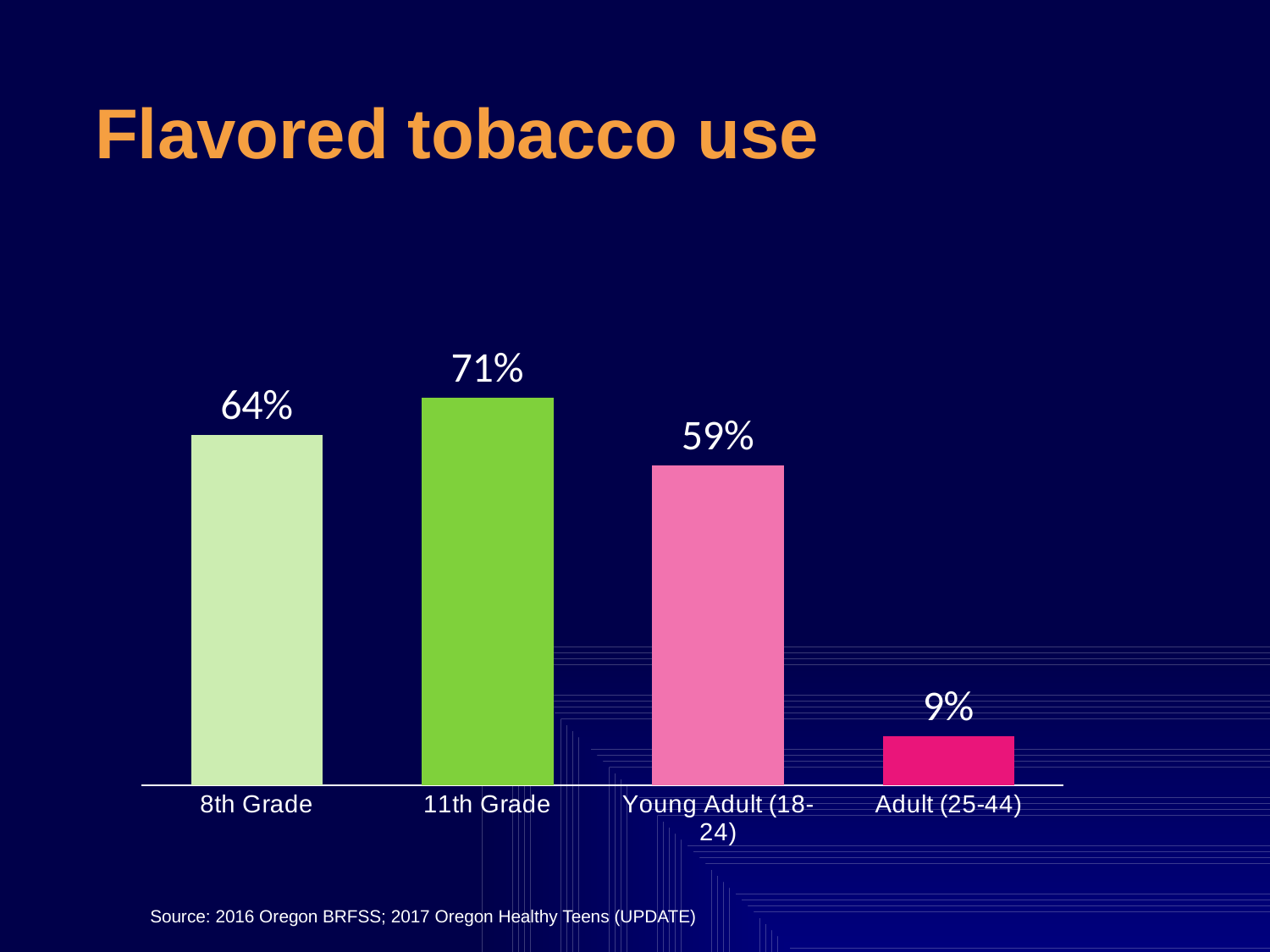
What is the difference between the Young Adult (18-24) and Adult (25-44) values? 50% Which category has the lowest flavored tobacco use? Adult (25-44) What is the flavored tobacco use value for 11th Grade? 71% What is the flavored tobacco use value for 8th Grade? 64% Which category has the highest flavored tobacco use? 11th Grade What kind of chart is shown on the slide? Bar chart Which is larger, the value for 8th Grade or the value for Young Adult (18-24)? 8th Grade How many categories are shown in the chart? 4 What is the difference between the 11th Grade and 8th Grade values? 7% What is the flavored tobacco use value for Young Adult (18-24)? 59% What is the title of the slide? Flavored tobacco use What is the flavored tobacco use value for Adult (25-44)? 9%